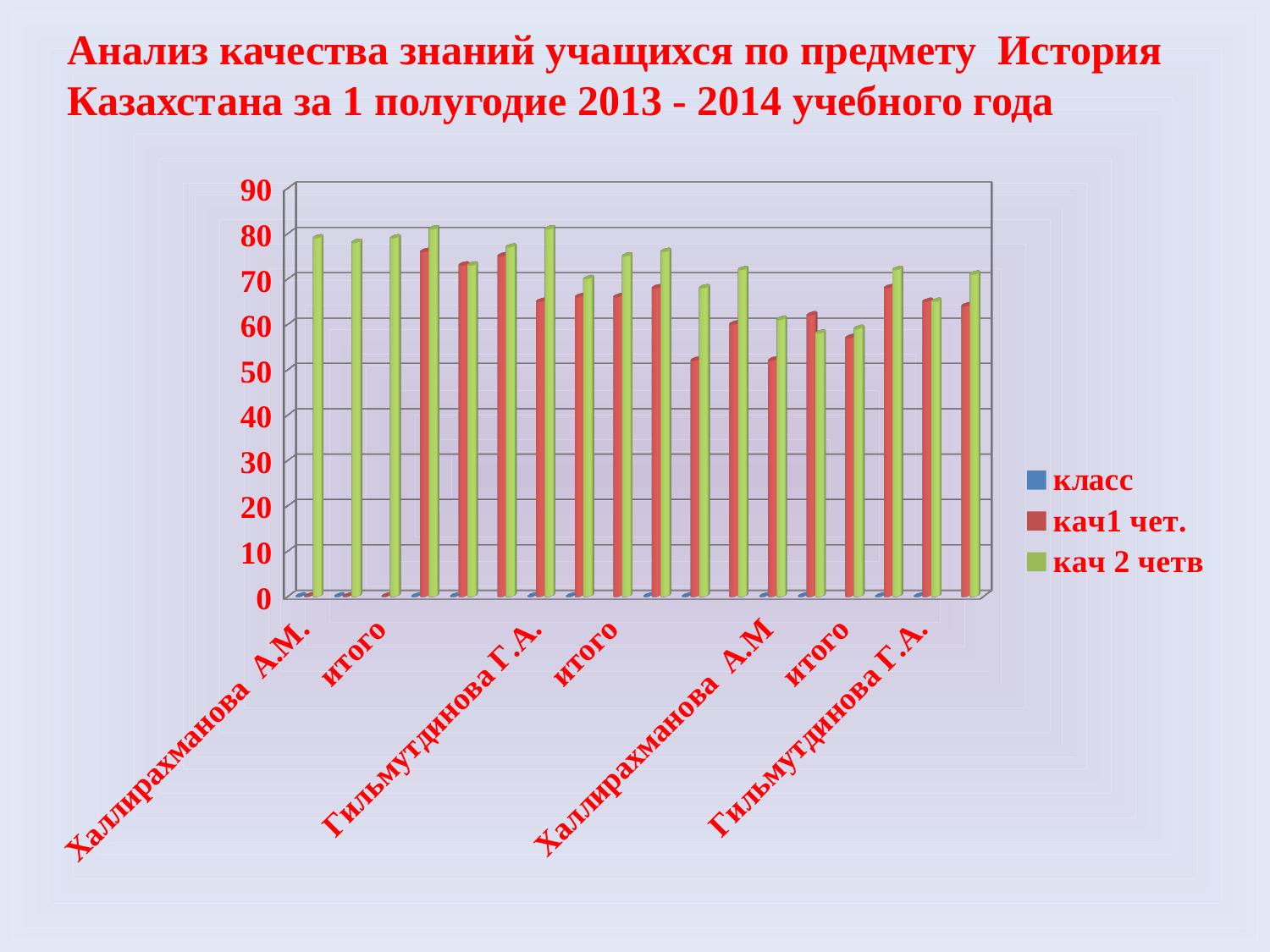
Which series contains the tallest bar in the chart? кач 2 четв Does any bar in the chart exceed 90? No Which series has bars that are barely visible, close to 0, in every category? класс How many series does the legend list? 3 Is the кач 2 четв value for the leftmost category (Халлирахманова А.М.) greater or less than 70? greater What is the highest value shown on the vertical axis? 90 What kind of chart is shown on the slide? bar chart Which series is drawn in green? кач 2 четв What are the series names listed in the legend? класс, кач1 чет., кач 2 четв Is the кач1 чет. value for the leftmost category (Халлирахманова А.М.) greater or less than 10? less